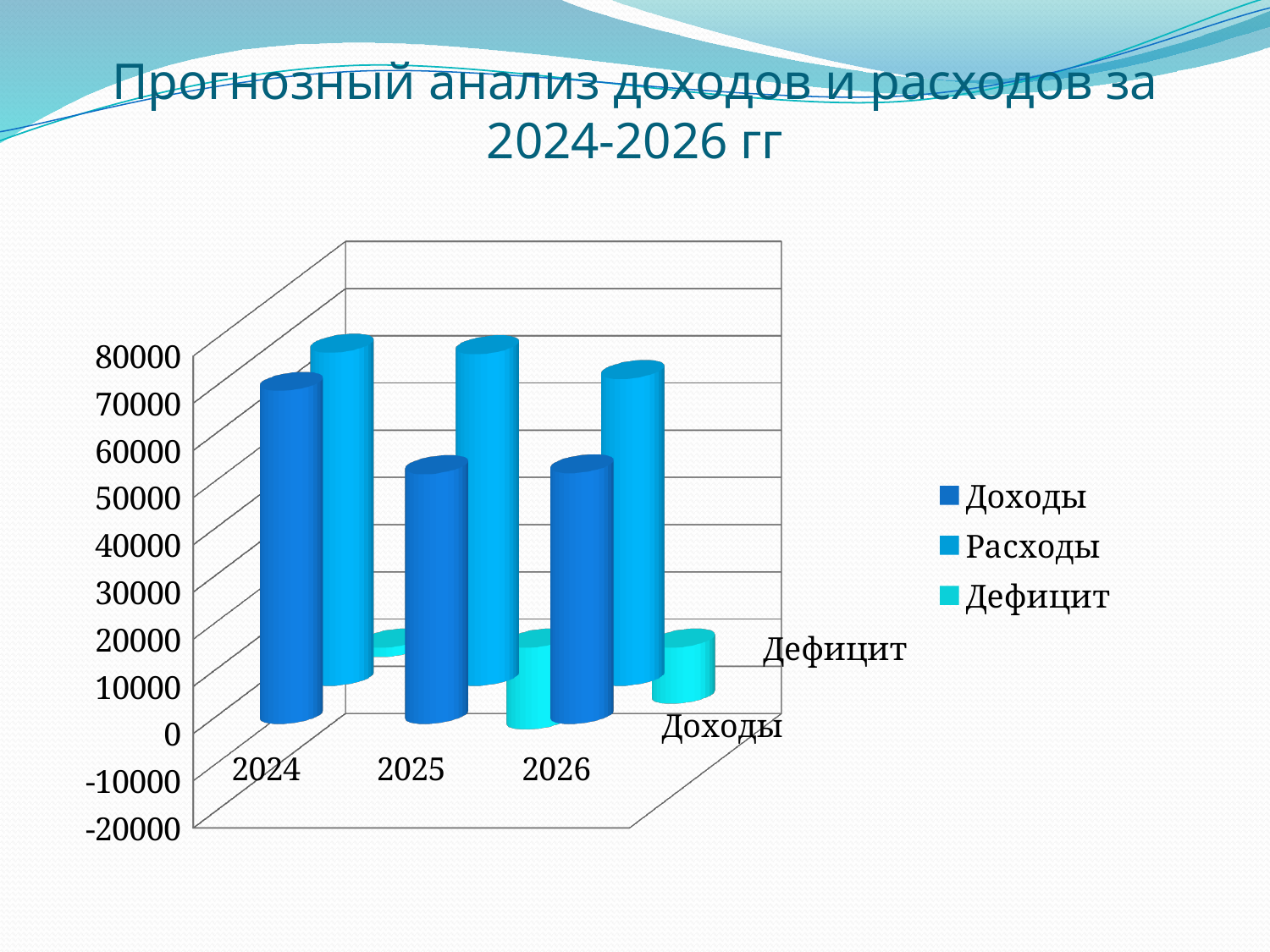
In which year is the value for Расходы the lowest? 2026 Is the value for Доходы in 2025 greater or less than 70000? less Which series are listed in the legend? Доходы, Расходы, Дефицит How many series does the legend list? 3 What is the title of the chart? Прогнозный анализ доходов и расходов за 2024-2026 гг Do the values for Расходы rise or fall from 2024 to 2026? fall Is the value for Расходы in 2024 greater or less than 50000? greater Is the value for Доходы in 2024 greater or less than 60000? greater In which year is the value for Доходы the highest? 2024 How many years are shown on the x axis? 3 What kind of chart is shown on the slide? bar chart